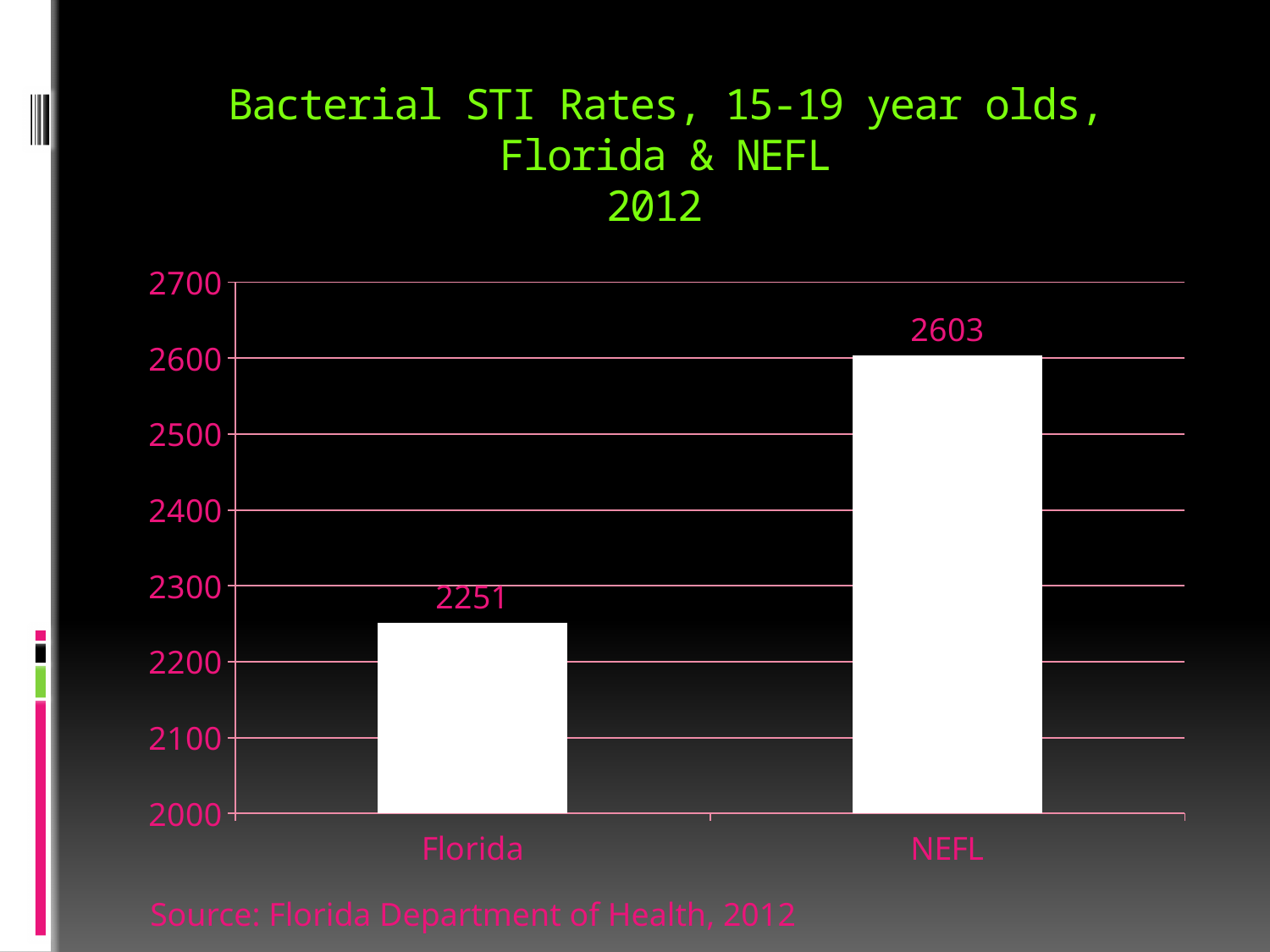
What is the bacterial STI rate for NEFL? 2603 Is the value for Florida greater or less than 2300? less Which is larger, the value for Florida or the value for NEFL? NEFL What source is cited below the chart? Florida Department of Health, 2012 What is the difference between the NEFL value and the Florida value? 352 Which category has the lowest value? Florida What is the title of the chart? Bacterial STI Rates, 15-19 year olds, Florida & NEFL 2012 What is the bacterial STI rate for Florida? 2251 What kind of chart is shown on the slide? bar chart Which category has the highest value? NEFL How many categories are shown on the x axis? 2 Is the value for NEFL greater or less than 2500? greater